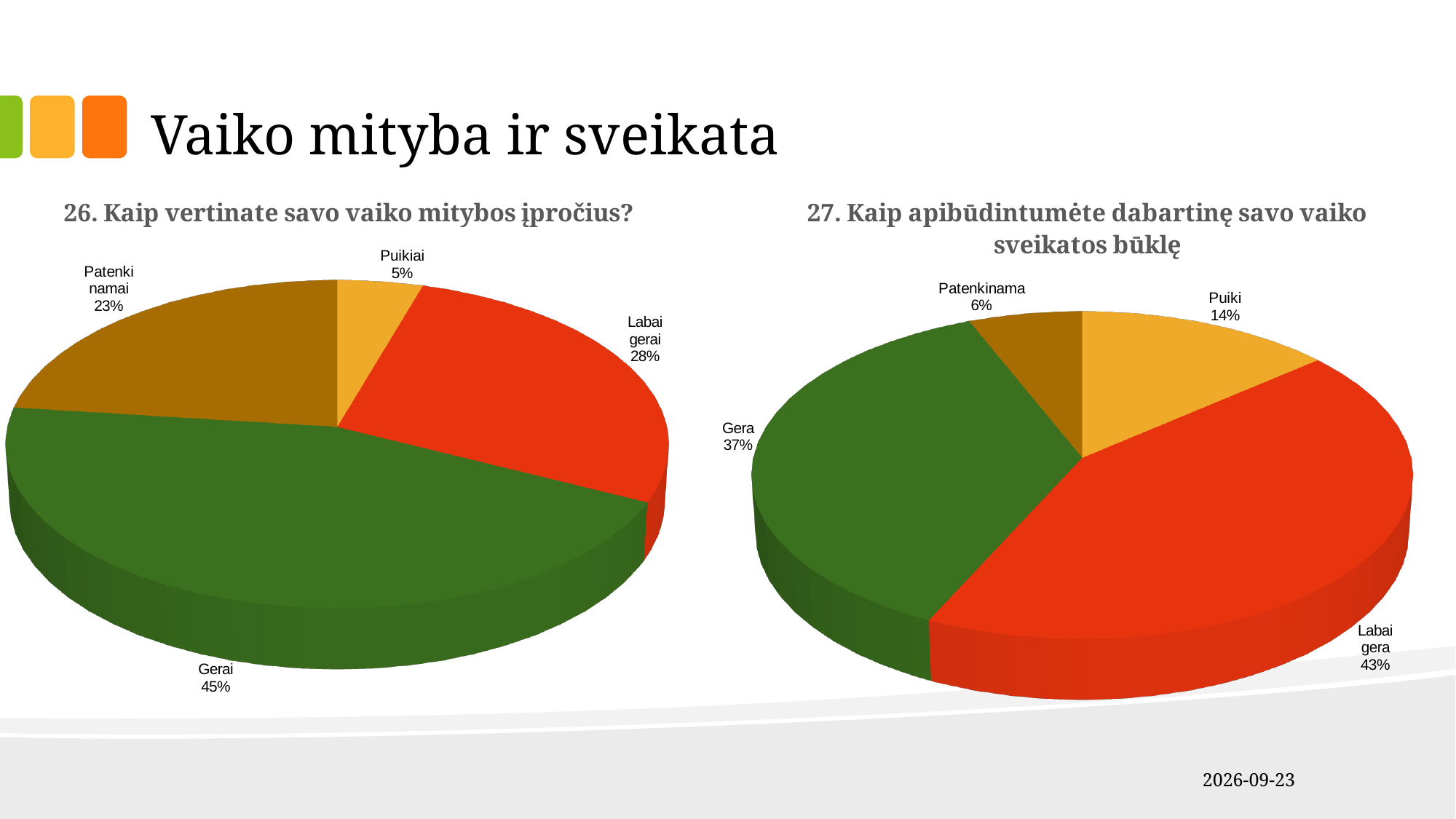
In the left chart (26. Kaip vertinate savo vaiko mitybos įpročius?), which category has the largest slice? Gerai In the right chart (27. Kaip apibūdintumėte dabartinę savo vaiko sveikatos būklę), what share is labelled for Patenkinama? 6% In the right chart (27. Kaip apibūdintumėte dabartinę savo vaiko sveikatos būklę), what is the difference in percentage points between Labai gera and Gera? 6 In the left chart (26. Kaip vertinate savo vaiko mitybos įpročius?), which category has the smallest slice? Puikiai In the right chart (27. Kaip apibūdintumėte dabartinę savo vaiko sveikatos būklę), what share is labelled for Labai gera? 43% What type of chart is used on the left side of the slide? Pie chart In the left chart (26. Kaip vertinate savo vaiko mitybos įpročius?), what is the difference in percentage points between Labai gerai and Patenkinamai? 5 In the right chart (27. Kaip apibūdintumėte dabartinę savo vaiko sveikatos būklę), which is larger, Gera or Puiki? Gera In the left chart (26. Kaip vertinate savo vaiko mitybos įpročius?), what share is labelled for Gerai? 45% In the left chart (26. Kaip vertinate savo vaiko mitybos įpročius?), how many slices does the pie have? 4 In the left chart (26. Kaip vertinate savo vaiko mitybos įpročius?), what share is labelled for Puikiai? 5% In the right chart (27. Kaip apibūdintumėte dabartinę savo vaiko sveikatos būklę), which category has the largest slice? Labai gera